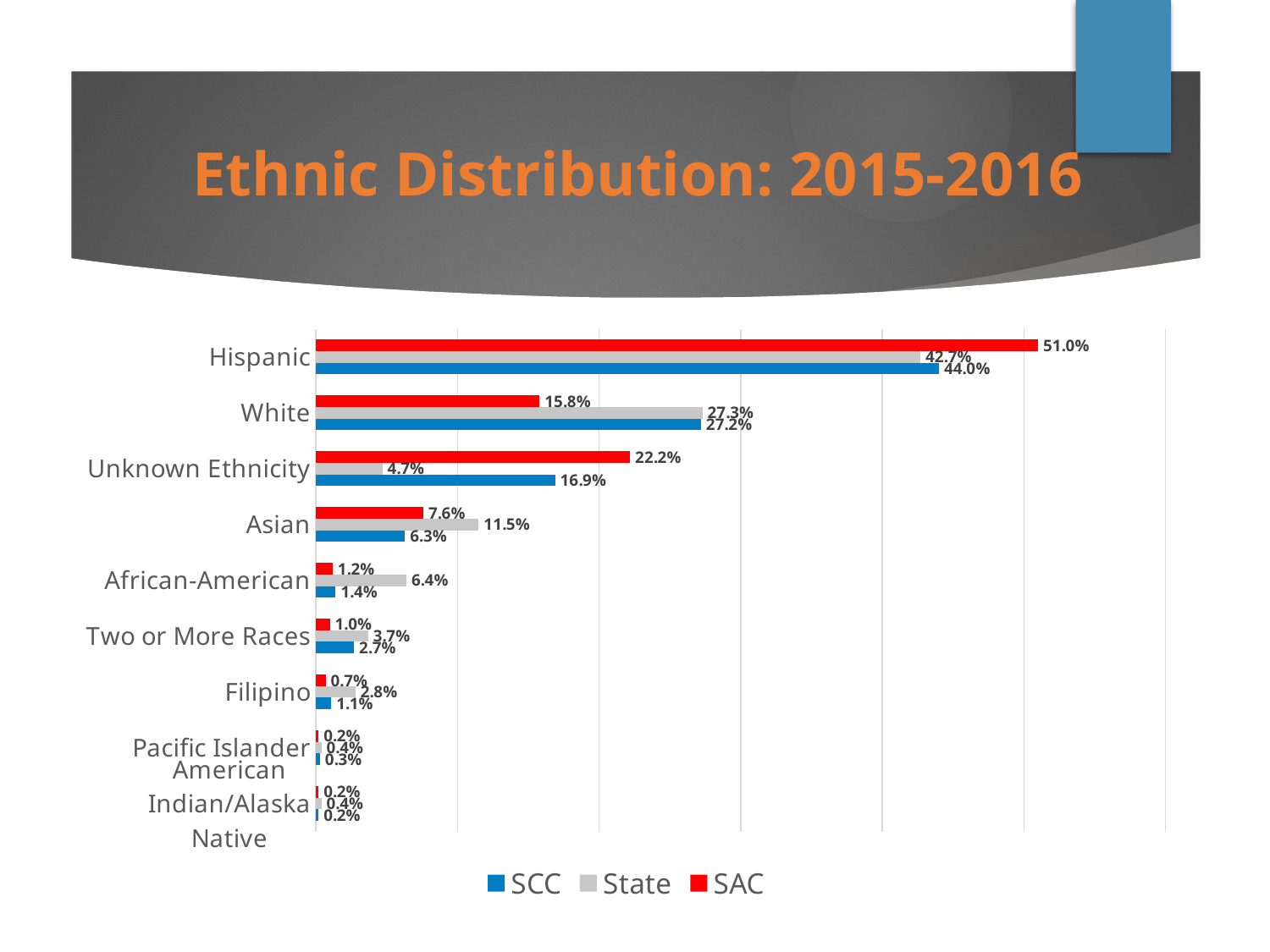
What is the title of the chart on the slide? Ethnic Distribution: 2015-2016 Which is larger for White: the SAC value or the State value? State What kind of chart is shown on the slide? Bar chart What is the State value for Unknown Ethnicity? 4.7% How many ethnic categories are plotted on the chart? 9 Which category has the highest SAC value? Hispanic What is the SAC value for Hispanic? 51.0% Which category has the lowest State value? Pacific Islander and American Indian/Alaska Native (both 0.4%) How many series does the legend list? 3 What is the difference between the SAC and SCC values for Unknown Ethnicity? 5.3% What is the difference between the SAC and State values for Hispanic? 8.3% What is the SCC value for Asian? 6.3%